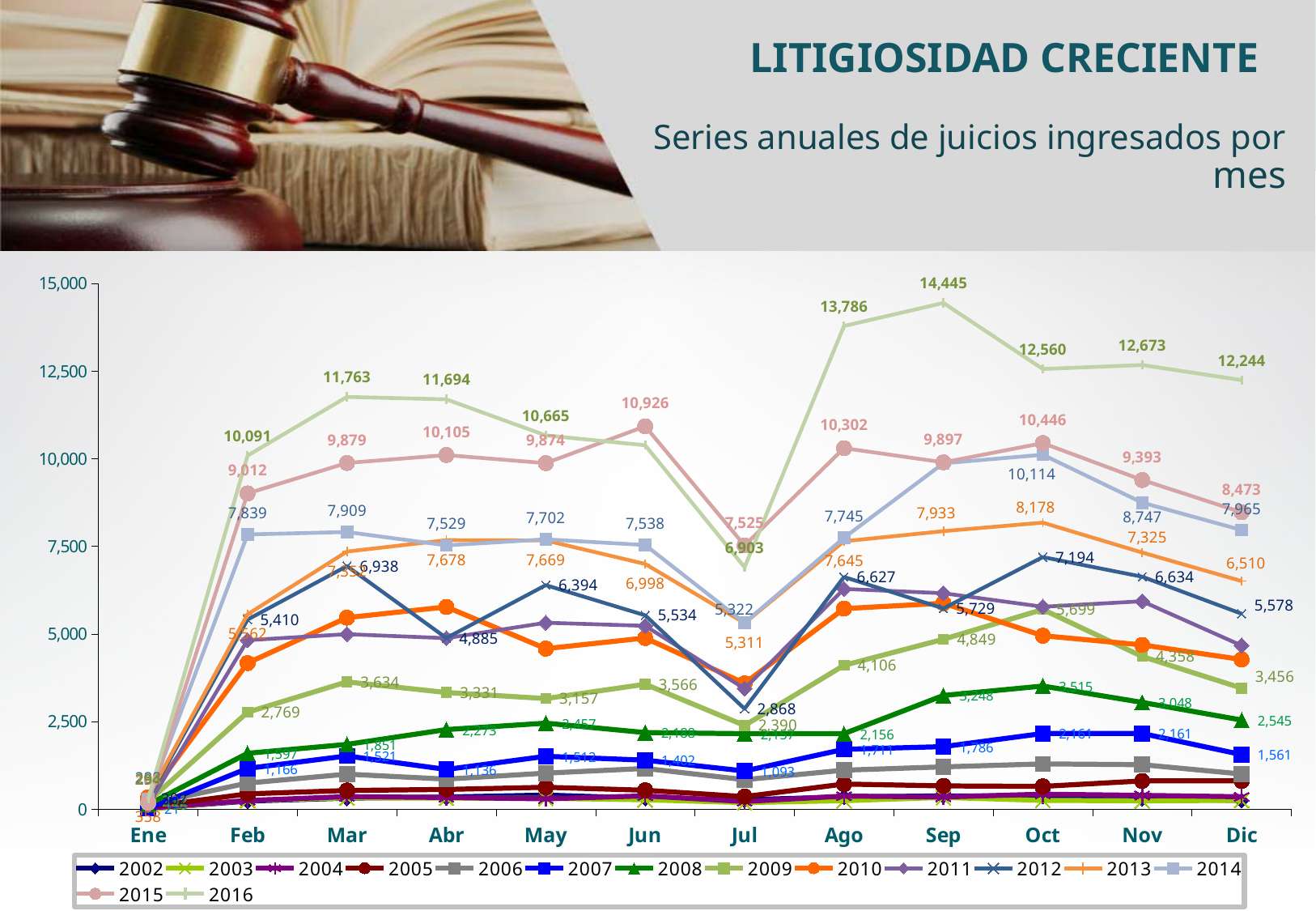
In which month does the 2016 series reach its highest value? Sep What is the value for the 2012 series in Jul? 2,868 What kind of chart is shown on the slide? line chart What is the value for the 2016 series in Sep? 14,445 Does the 2016 series rise or fall from Ene to Feb? rise Is the value for the 2016 series in Jul greater or less than 7,500? less What is the value for the 2014 series in Oct? 10,114 What is the value for the 2015 series in Jun? 10,926 How many series does the legend list? 15 Which is larger in Dic: the 2015 series or the 2014 series? 2015 What is the difference between the 2016 values in Sep (14,445) and Ago (13,786)? 659 How many months are shown along the x axis? 12